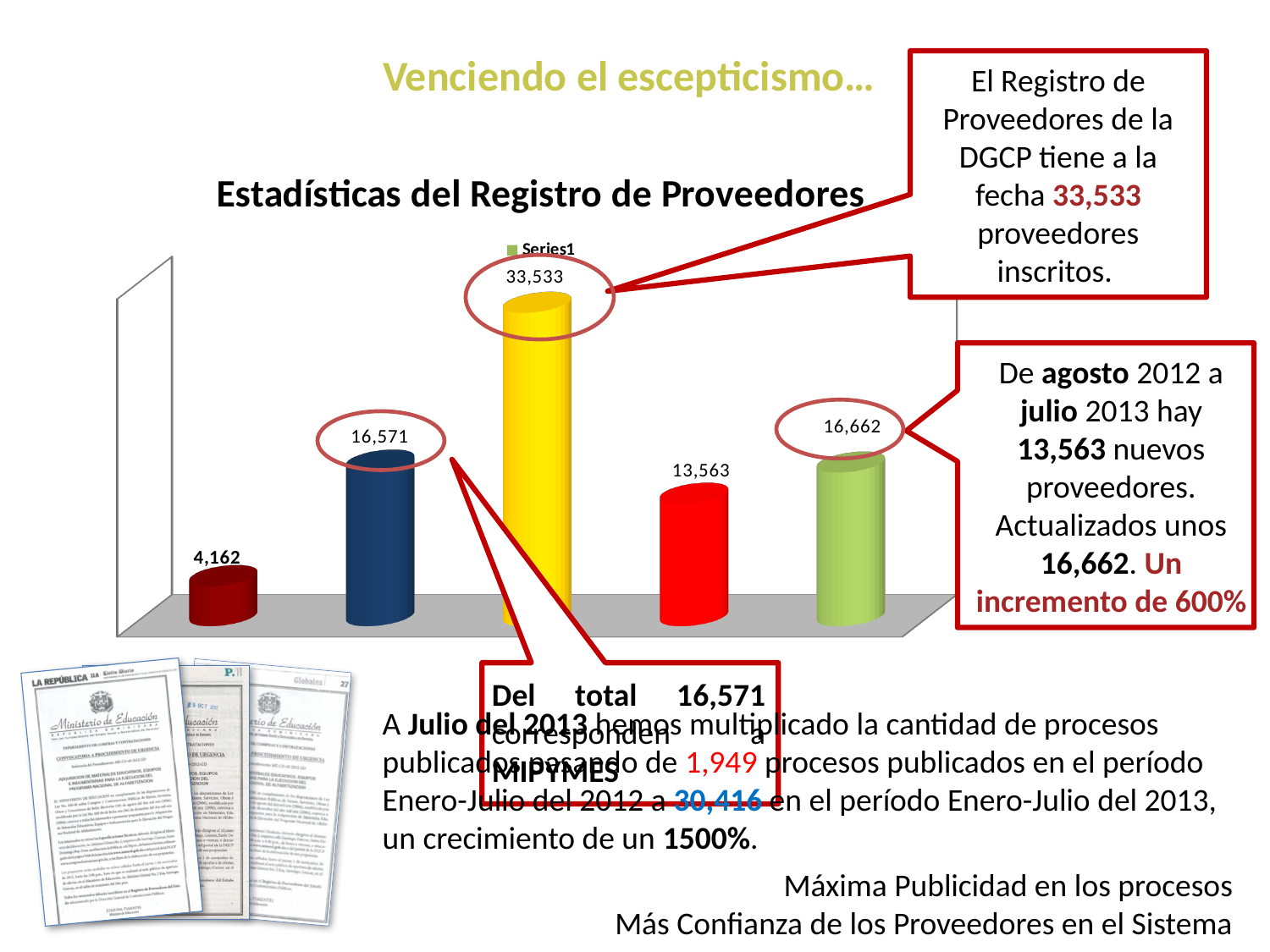
How many series does the chart legend list? 1 How many bars are plotted in the chart? 5 Which bar has the larger value, the dark blue bar or the bright red bar? the dark blue bar What value is labelled on the yellow bar? 33,533 What value is labelled on the green bar on the far right? 16,662 What type of chart is shown under the title "Estadísticas del Registro de Proveedores"? bar chart What is the name of the series shown in the chart legend? Series1 What value is labelled on the dark blue bar? 16,571 What is the value shown on the shortest bar in the chart? 4,162 What value is labelled on the bright red bar, fourth from the left? 13,563 What is the difference between the value of the yellow bar (33,533) and the dark blue bar (16,571)? 16,962 What is the value shown on the tallest bar in the chart? 33,533